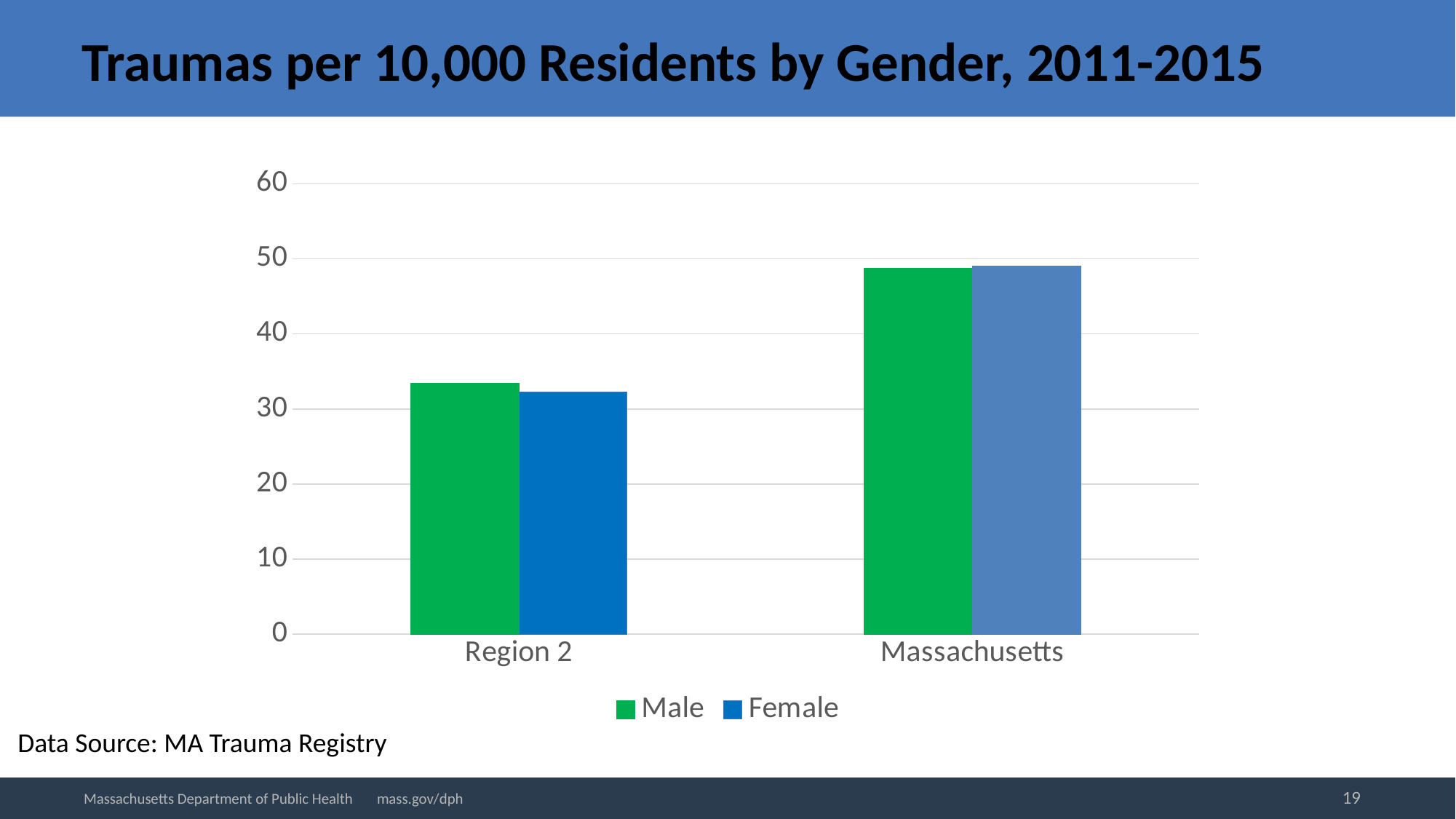
Is the Female value for Region 2 greater or less than 30? greater Is the Female value for Massachusetts greater or less than 40? greater Is the Male value for Massachusetts greater or less than 40? greater What kind of chart is shown on the slide? Bar chart Which category has the lower trauma rates for both genders, Region 2 or Massachusetts? Region 2 How many series does the legend list? 2 How many categories are shown on the x axis? 2 What are the two series listed in the legend? Male and Female Which is larger, the Male value for Massachusetts or the Male value for Region 2? Massachusetts What is the title of the chart? Traumas per 10,000 Residents by Gender, 2011-2015